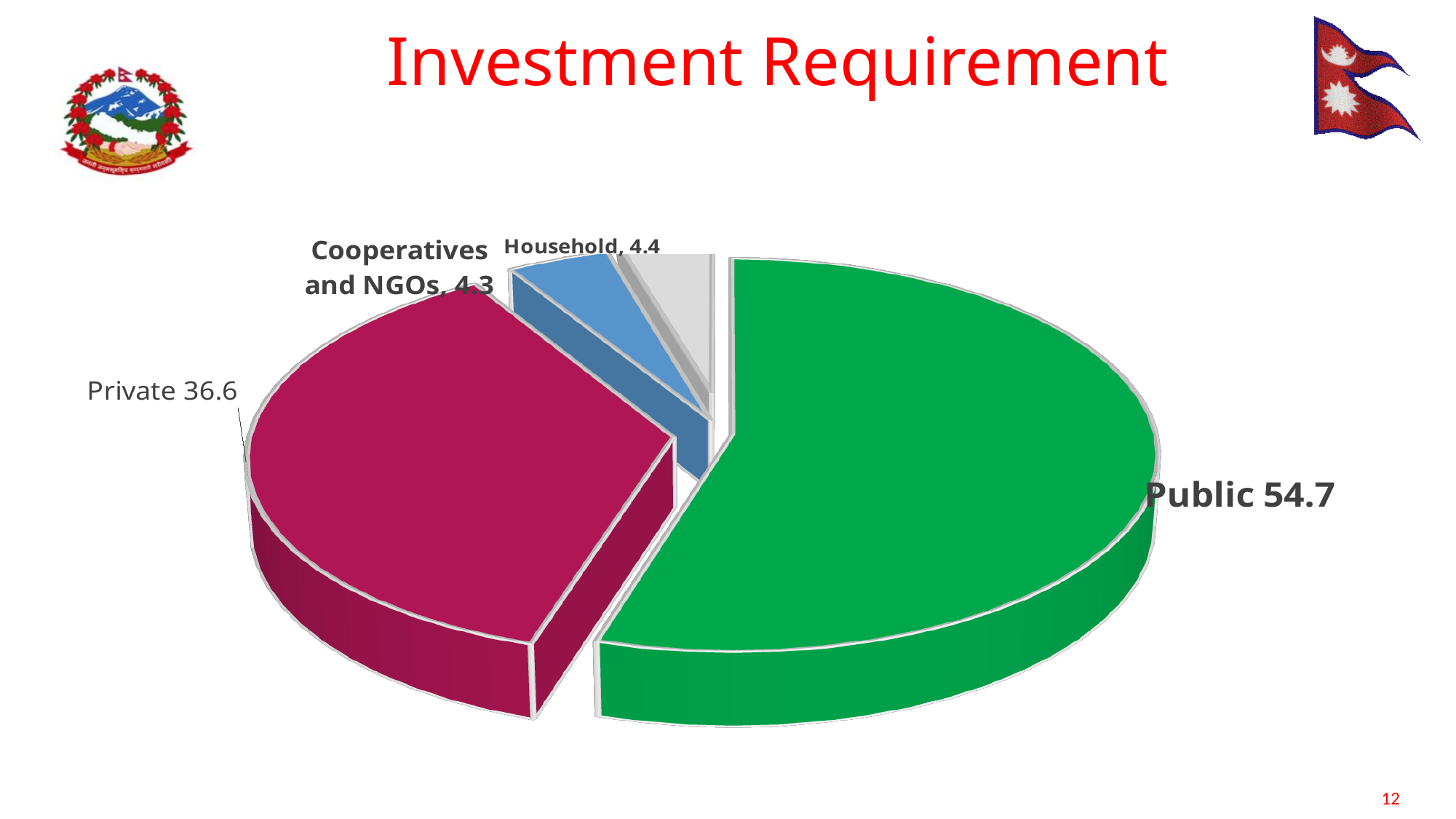
What kind of chart is shown on the slide? Pie chart Which is larger, the value for Public or the value for Private? Public Which category has the largest slice of the pie chart? Public What is the value for Public in the pie chart? 54.7 How many slices does the pie chart have? 4 What is the value for Cooperatives and NGOs in the pie chart? 4.3 What is the value for Household in the pie chart? 4.4 What is the difference between the values for Public and Private? 18.1 What is the title of the slide containing the chart? Investment Requirement What is the difference between the values for Private and Household? 32.2 Which category has the smallest value in the pie chart? Cooperatives and NGOs What is the value for Private in the pie chart? 36.6